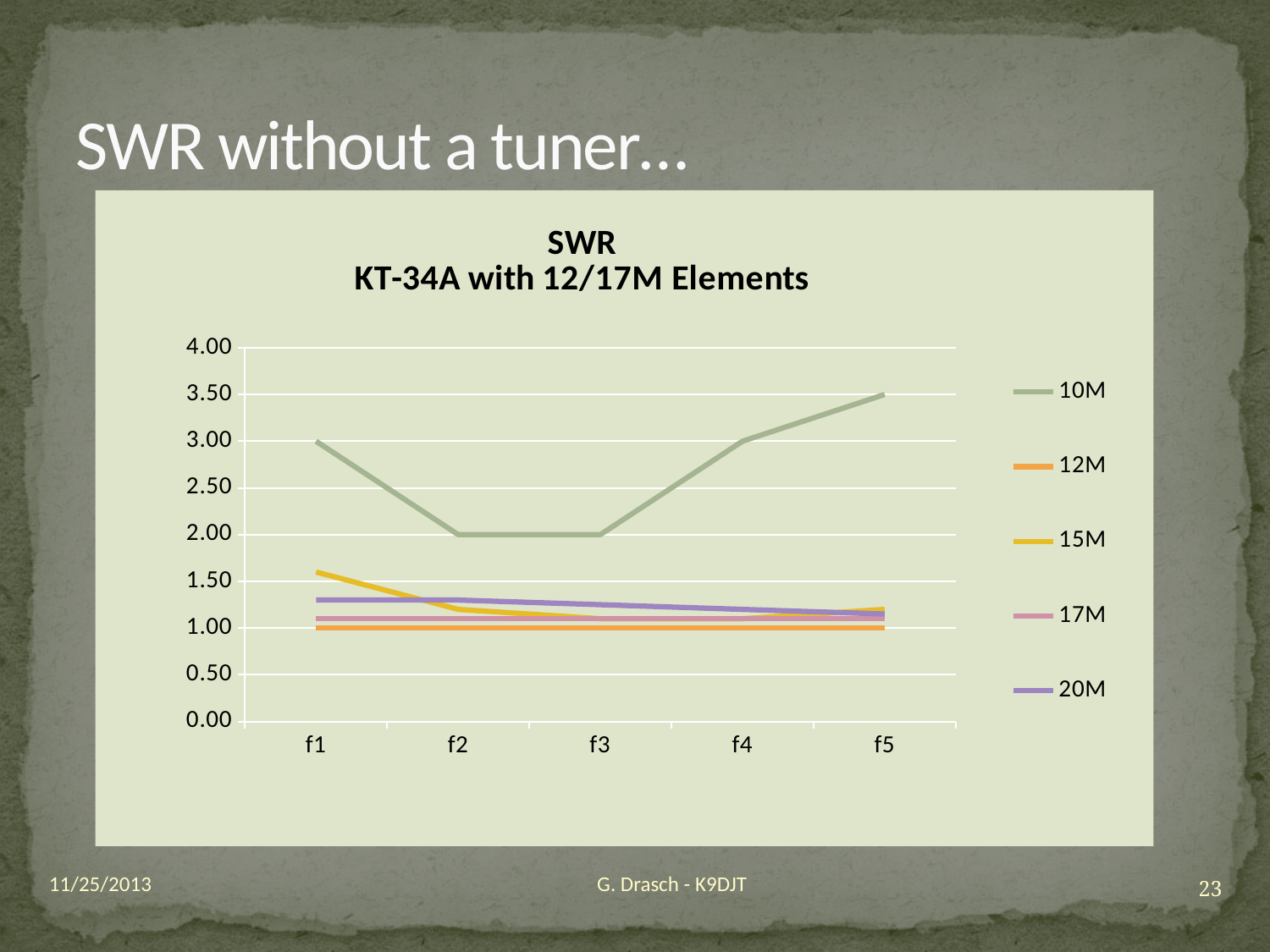
Which series has the lowest SWR at f3? 12M How many series does the legend list? 5 For the 10M series, is the value at f1 or at f2 larger? f1 What kind of chart is shown on the slide? line chart Does the 10M series rise or fall from f3 to f5? rise What is the SWR value for the 10M series at f5? 3.50 How many frequency points are plotted along the x axis? 5 What is the SWR value for the 10M series at f2? 2.00 Which series has the highest SWR at f1? 10M Is the value for the 20M series at f4 greater or less than 1.50? less What is the SWR value for the 10M series at f1? 3.00 Is the value for the 15M series at f1 greater or less than 1.50? greater